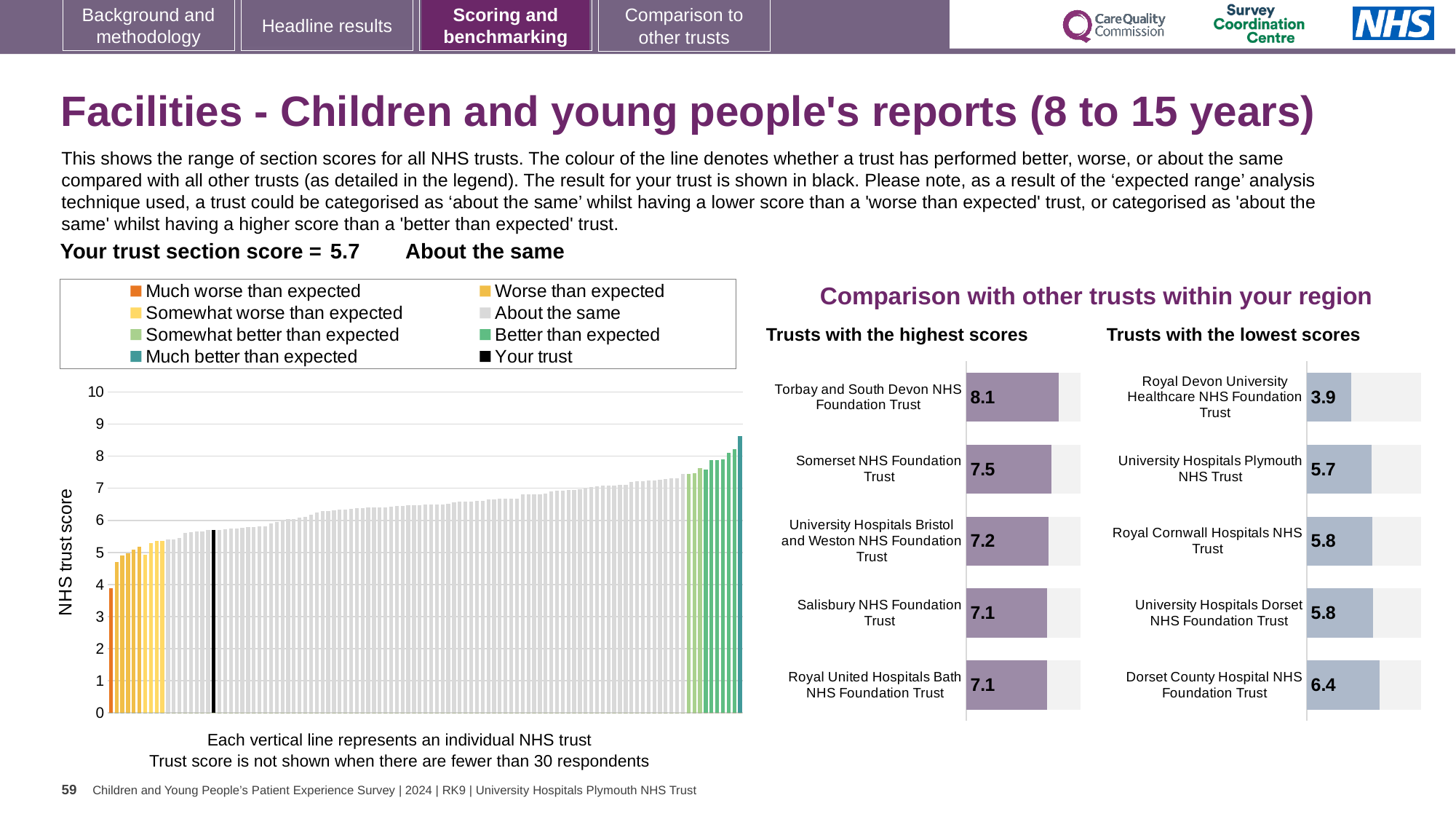
What kind of chart is the large 'NHS trust score' chart on the left of the slide? Bar chart In the 'Trusts with the lowest scores' chart, which trust has the lowest score? Royal Devon University Healthcare NHS Foundation Trust In the 'Trusts with the highest scores' chart, what is the score for Torbay and South Devon NHS Foundation Trust? 8.1 How many trusts are shown in the 'Trusts with the lowest scores' chart? 5 In the 'Trusts with the highest scores' chart, what is the difference between the scores of Torbay and South Devon NHS Foundation Trust and Somerset NHS Foundation Trust? 0.6 In the 'Trusts with the highest scores' chart, which trust has the highest score? Torbay and South Devon NHS Foundation Trust Which has the higher score: Somerset NHS Foundation Trust in the 'highest scores' chart or Dorset County Hospital NHS Foundation Trust in the 'lowest scores' chart? Somerset NHS Foundation Trust In the large 'NHS trust score' chart on the left, what is the section score for your trust (the black bar)? 5.7 In the 'Trusts with the lowest scores' chart, what is the score for Royal Devon University Healthcare NHS Foundation Trust? 3.9 How many entries does the legend above the large 'NHS trust score' chart list? 8 In the large 'NHS trust score' chart on the left, do the bar values rise or fall from left to right? Rise In the 'Trusts with the lowest scores' chart, what is the difference between the scores of Dorset County Hospital NHS Foundation Trust and Royal Devon University Healthcare NHS Foundation Trust? 2.5